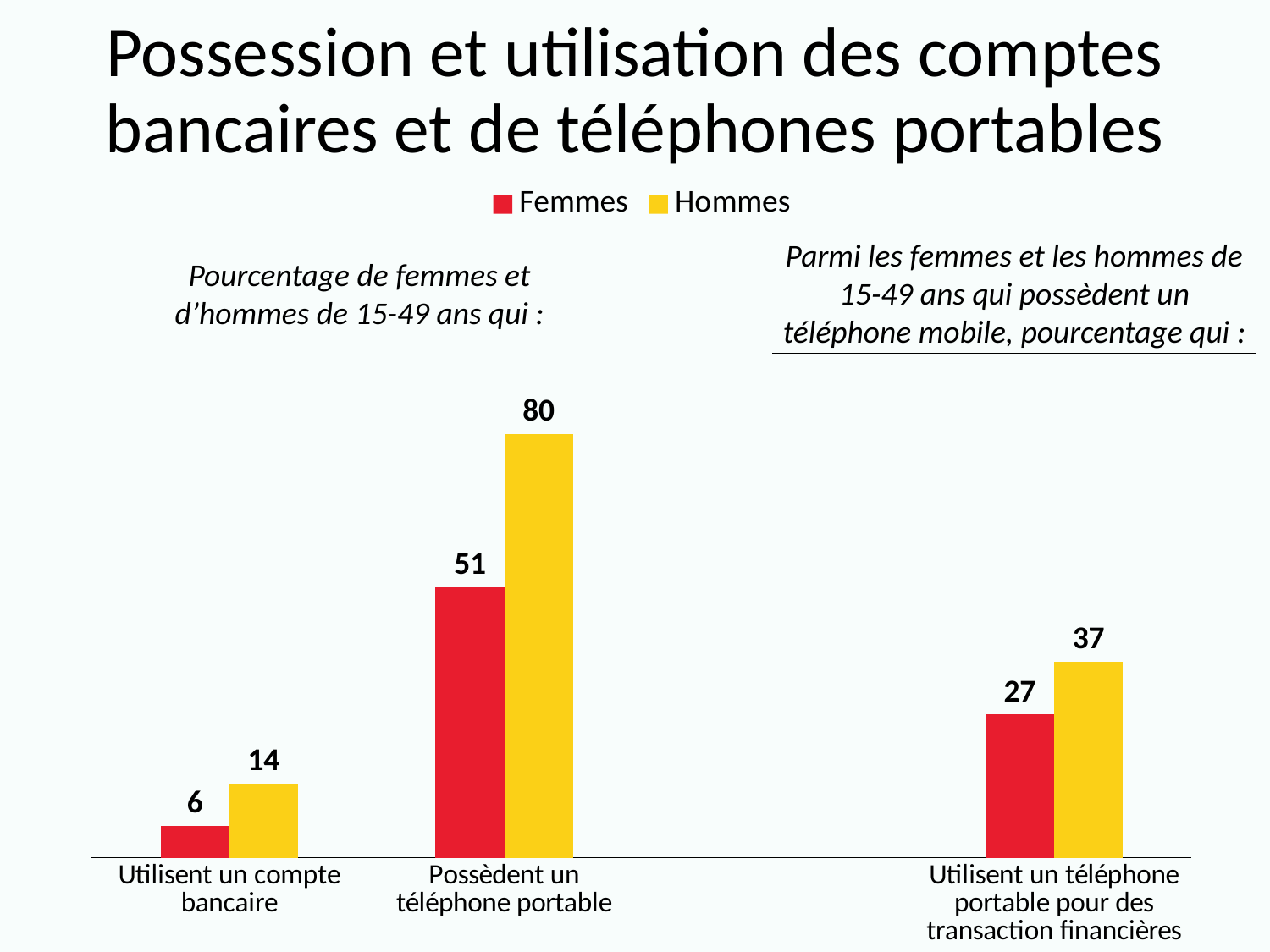
What is the value for Hommes in the 'Possèdent un téléphone portable' category? 80 What is the value for Femmes in the 'Utilisent un compte bancaire' category? 6 What is the difference between the Hommes and Femmes values for 'Utilisent un téléphone portable pour des transaction financières'? 10 What is the value for Femmes in the 'Utilisent un téléphone portable pour des transaction financières' category? 27 What kind of chart is shown on the slide? Bar chart Which category has the lowest value for Femmes? Utilisent un compte bancaire How many categories are shown on the x axis? 3 Which category has the highest value for Hommes? Possèdent un téléphone portable What is the value for Hommes in the 'Utilisent un compte bancaire' category? 14 What is the difference between the Hommes and Femmes values for 'Possèdent un téléphone portable'? 29 Which is larger: the Femmes value for 'Possèdent un téléphone portable' or the Hommes value for 'Utilisent un téléphone portable pour des transaction financières'? Femmes value for 'Possèdent un téléphone portable' How many series does the legend list? 2